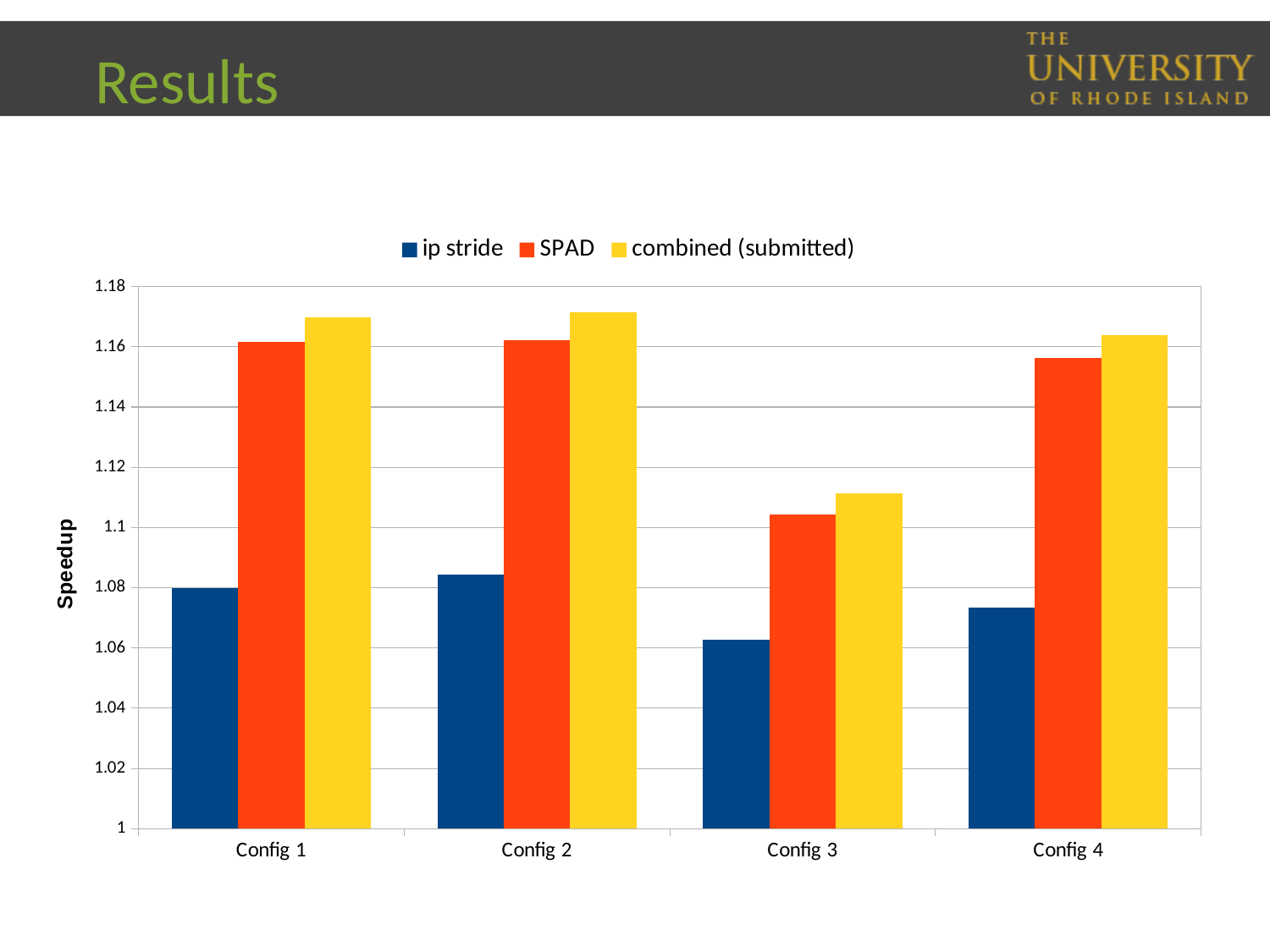
Which configuration has the lowest combined (submitted) speedup? Config 3 Is the ip stride value for Config 3 greater or less than 1.08? less Which is larger: the SPAD value for Config 3 or the ip stride value for Config 4? SPAD for Config 3 What is the label of the y axis? Speedup Which configuration has the lowest ip stride speedup? Config 3 Is the combined (submitted) value for Config 2 greater or less than 1.16? greater Is the SPAD value for Config 3 greater or less than 1.12? less What kind of chart is shown on the slide? bar chart How many configurations are shown along the x axis? 4 How many series does the legend list? 3 Which series is shown in yellow in the legend? combined (submitted)